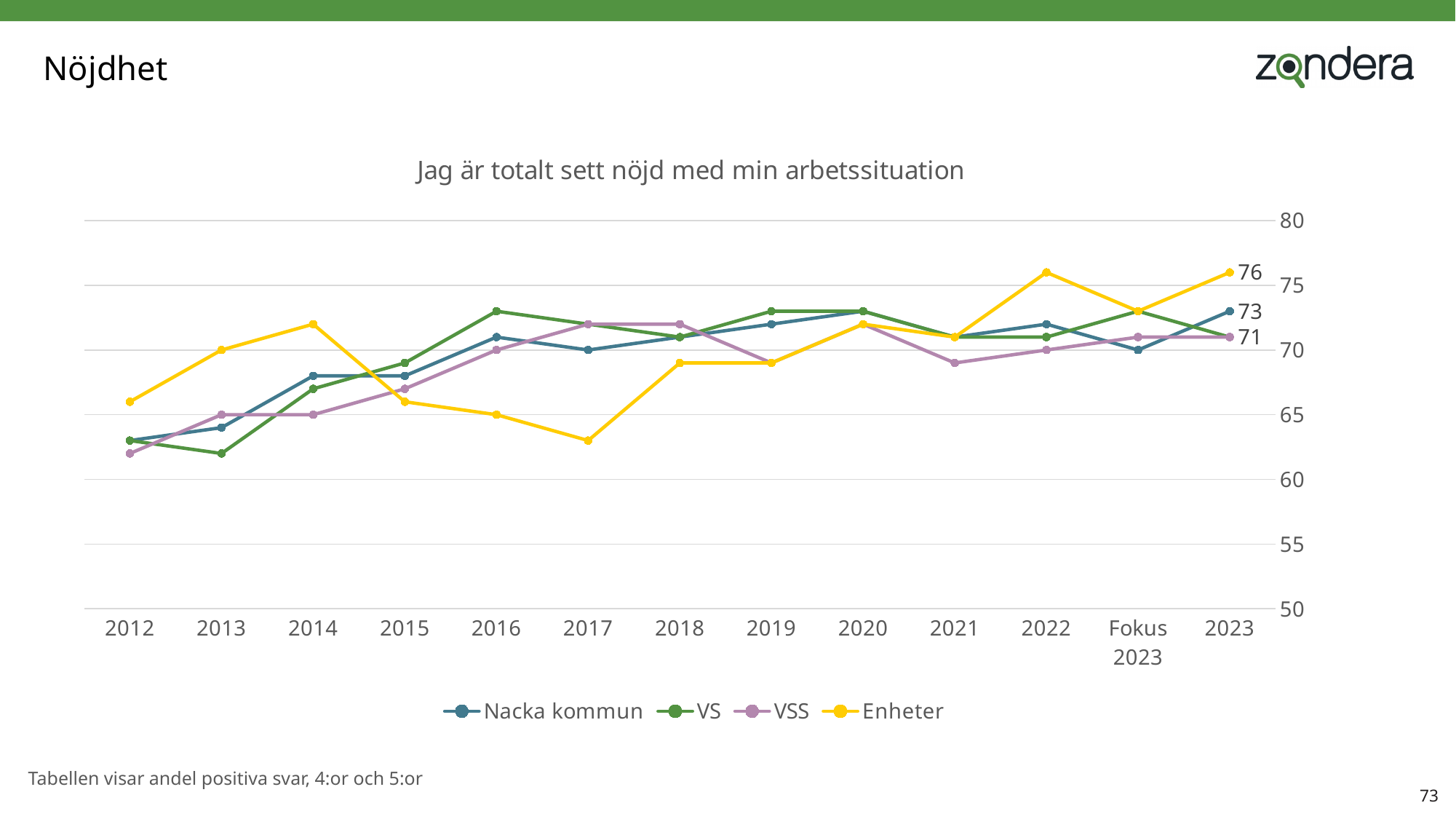
Which series has the highest value in 2023? Enheter Is the value for Enheter in 2017 greater or less than 65? less What is the value for Nacka kommun in 2023? 73 How many points are there along the x axis? 13 What is the title of the chart? Jag är totalt sett nöjd med min arbetssituation Does the Nacka kommun series generally rise or fall from 2012 to 2023? rise What is the value for Enheter in 2023? 76 What type of chart is shown on the slide? line chart Is the value for Nacka kommun in 2014 greater or less than 65? greater What is the difference between the Enheter and Nacka kommun values in 2023? 3 In 2023, which is larger: the value for Enheter or the value for Nacka kommun? Enheter How many series does the legend list? 4